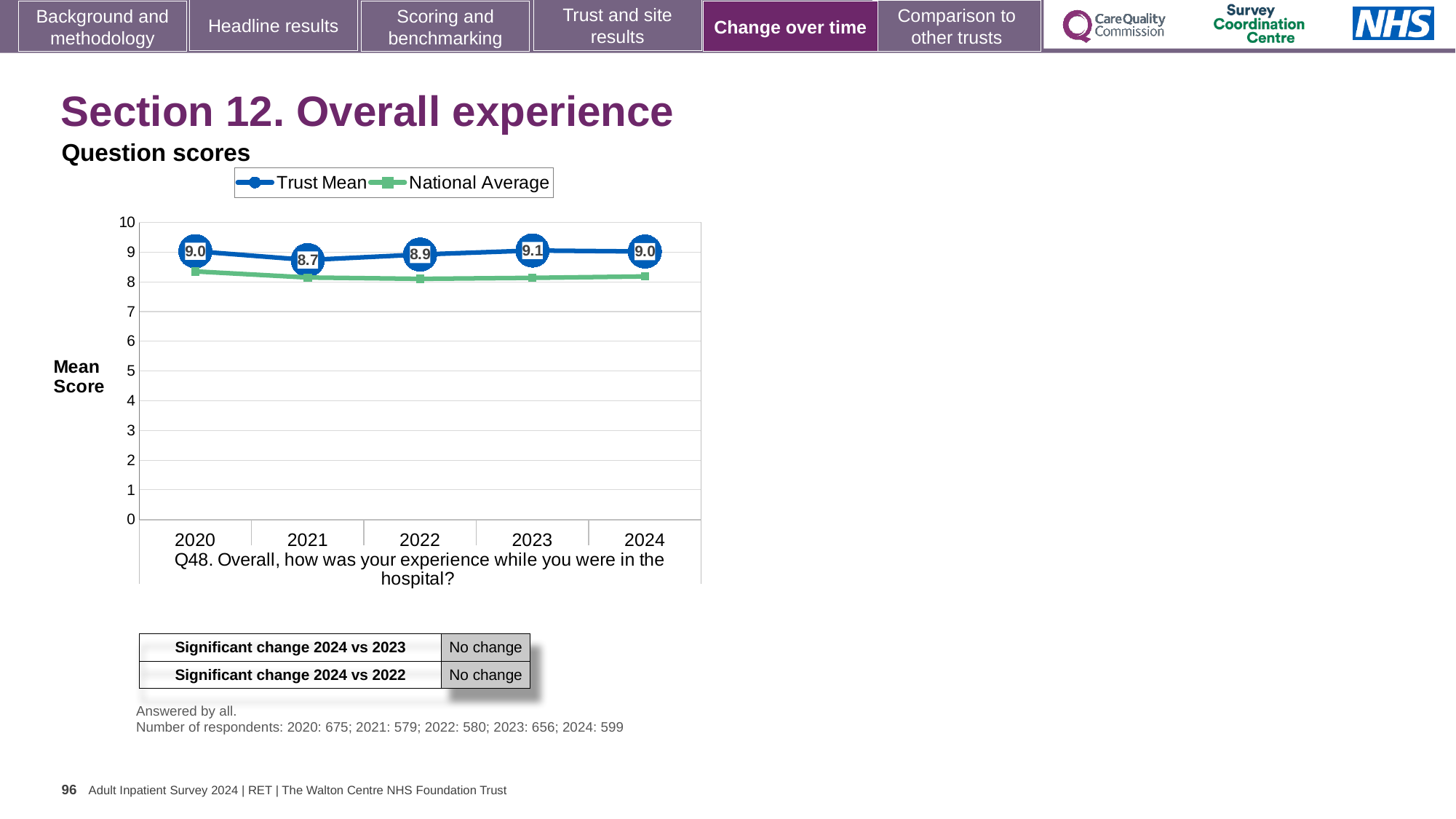
What is the Trust Mean score for 2023? 9.1 Is the National Average value for 2024 greater or less than 9? less In which year is the Trust Mean score lowest? 2021 How many years are shown on the x axis? 5 In which year is the Trust Mean score highest? 2023 What is the Trust Mean score for 2021? 8.7 What kind of chart is shown on the slide? Line chart What is the Trust Mean score for 2024? 9.0 What is the difference between the Trust Mean score in 2023 and in 2021? 0.4 Which is larger, the Trust Mean score in 2022 or in 2021? 2022 Does the Trust Mean score rise or fall from 2021 to 2023? Rise How many series does the legend list? 2